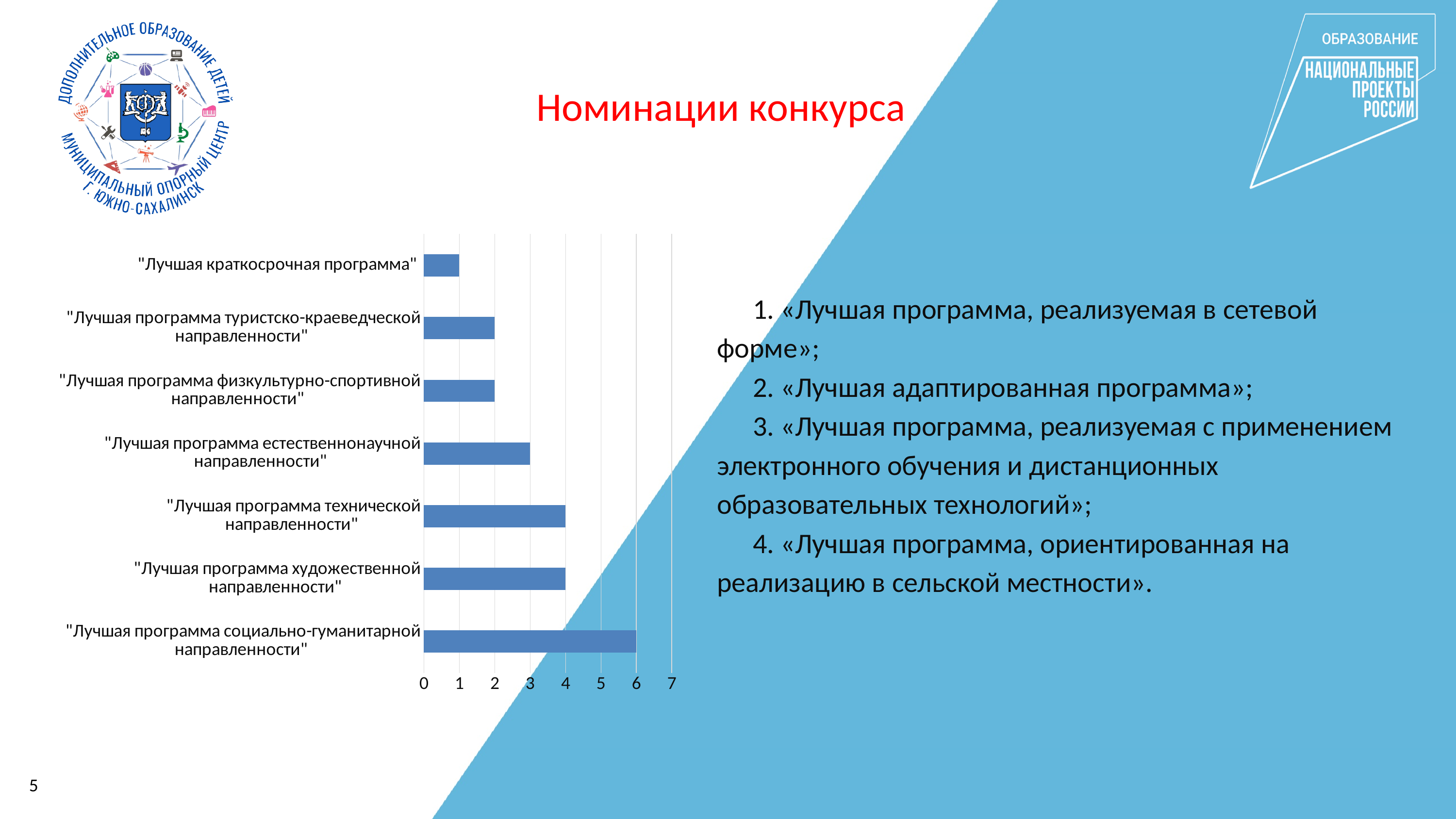
What is the value for "Лучшая краткосрочная программа"? 1 What is the difference between the values for "Лучшая программа социально-гуманитарной направленности" and "Лучшая программа художественной направленности"? 2 Is the value for "Лучшая программа социально-гуманитарной направленности" greater or less than 5? greater Which category has the lowest value? "Лучшая краткосрочная программа" What is the maximum value shown on the horizontal axis of the chart? 7 What is the value for "Лучшая программа естественнонаучной направленности"? 3 What is the value for "Лучшая программа технической направленности"? 4 Which is larger: the value for "Лучшая программа естественнонаучной направленности" or "Лучшая программа физкультурно-спортивной направленности"? "Лучшая программа естественнонаучной направленности" What is the value for "Лучшая программа социально-гуманитарной направленности"? 6 What kind of chart is shown on the slide? bar chart Which category has the highest value? "Лучшая программа социально-гуманитарной направленности" How many categories does the bar chart show? 7